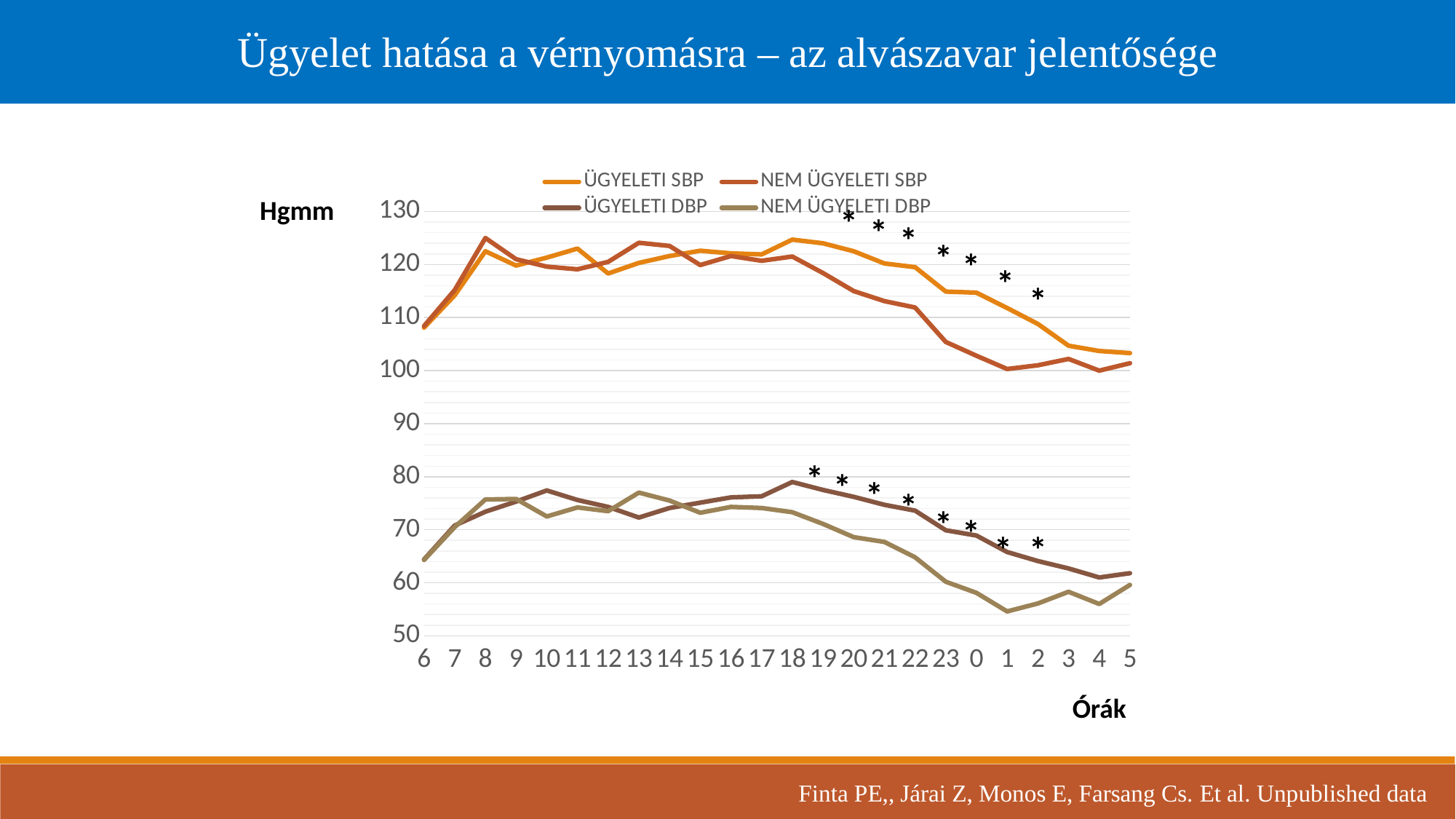
How many series does the legend list? 4 Is the value for ÜGYELETI SBP at hour 18 greater or less than 120? greater How many hour points are plotted along the x axis? 24 Does NEM ÜGYELETI SBP rise or fall from hour 18 to hour 1? fall At hour 1, which is larger: ÜGYELETI DBP or NEM ÜGYELETI DBP? ÜGYELETI DBP Is the value for ÜGYELETI DBP at hour 18 greater or less than 70? greater At hour 2, which is larger: ÜGYELETI SBP or NEM ÜGYELETI SBP? ÜGYELETI SBP Which series reaches the lowest value on the chart? NEM ÜGYELETI DBP Is the value for ÜGYELETI SBP at hour 0 greater or less than 110? greater What kind of chart is shown on the slide? line chart What unit label is shown next to the vertical axis? Hgmm